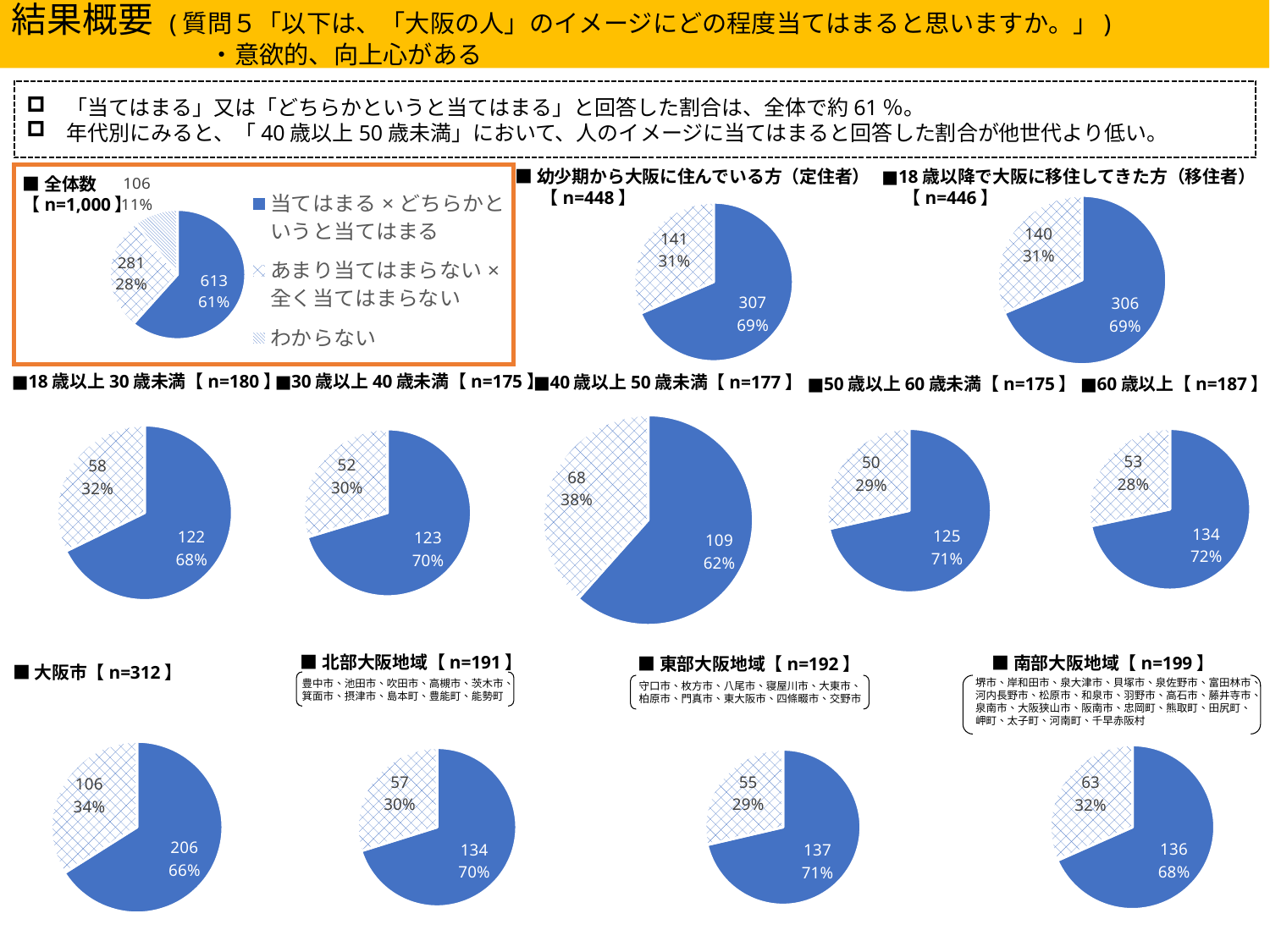
In the 全体数【n=1,000】 pie chart, what share of the pie is わからない? 11% In the 全体数【n=1,000】 pie chart, how many respondents answered 当てはまる × どちらかというと当てはまる? 613 In the 40歳以上50歳未満【n=177】 pie chart, what percentage is shown for the hatched (あまり当てはまらない × 全く当てはまらない) slice? 38% In the 北部大阪地域【n=191】 pie chart, how many respondents are in the hatched slice? 57 Among the five age-group pie charts (18歳以上30歳未満 to 60歳以上), which has the highest percentage for the solid blue slice? 60歳以上【n=187】 How many entries does the legend of the 全体数【n=1,000】 pie chart list? 3 In the 18歳以降で大阪に移住してきた方（移住者）【n=446】 pie chart, what is the value of the larger slice? 306 Among the five age-group pie charts (18歳以上30歳未満 to 60歳以上), which has the lowest percentage for the solid blue slice? 40歳以上50歳未満【n=177】 How many pie charts are shown on the slide in total? 12 In the 大阪市【n=312】 pie chart, what is the difference between the two slice counts (206 and 106)? 100 What kind of chart is used for the 幼少期から大阪に住んでいる方（定住者）【n=448】 data? Pie chart Which is larger: the solid blue slice percentage in the 東部大阪地域【n=192】 chart or in the 南部大阪地域【n=199】 chart? 東部大阪地域【n=192】